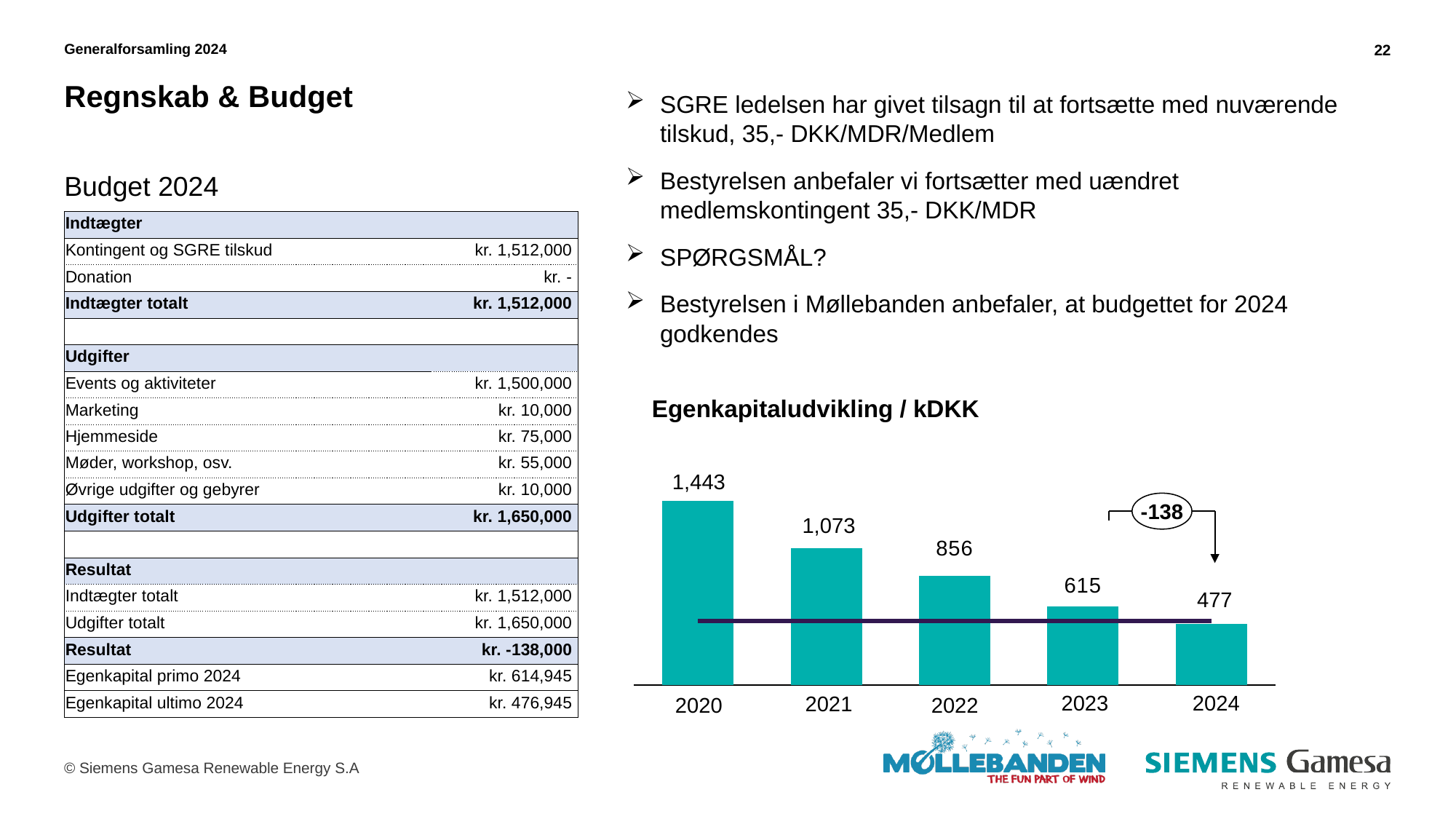
Do the values in the Egenkapitaludvikling / kDKK chart rise or fall from 2020 to 2024? Fall Which year has the lowest value in the Egenkapitaludvikling / kDKK chart? 2024 How many years are shown in the Egenkapitaludvikling / kDKK chart? 5 What is the value for 2024 in the Egenkapitaludvikling / kDKK chart? 477 What is the difference between the 2020 and 2021 values in the Egenkapitaludvikling / kDKK chart? 370 What is the value for 2022 in the Egenkapitaludvikling / kDKK chart? 856 What kind of chart is the Egenkapitaludvikling / kDKK chart? Bar chart Which year has the highest value in the Egenkapitaludvikling / kDKK chart? 2020 What change is shown in the callout above the 2024 bar in the Egenkapitaludvikling / kDKK chart? -138 What is the value for 2020 in the Egenkapitaludvikling / kDKK chart? 1,443 In the Egenkapitaludvikling / kDKK chart, is the value for 2021 or 2022 larger? 2021 What is the difference between the 2023 and 2024 values in the Egenkapitaludvikling / kDKK chart? 138